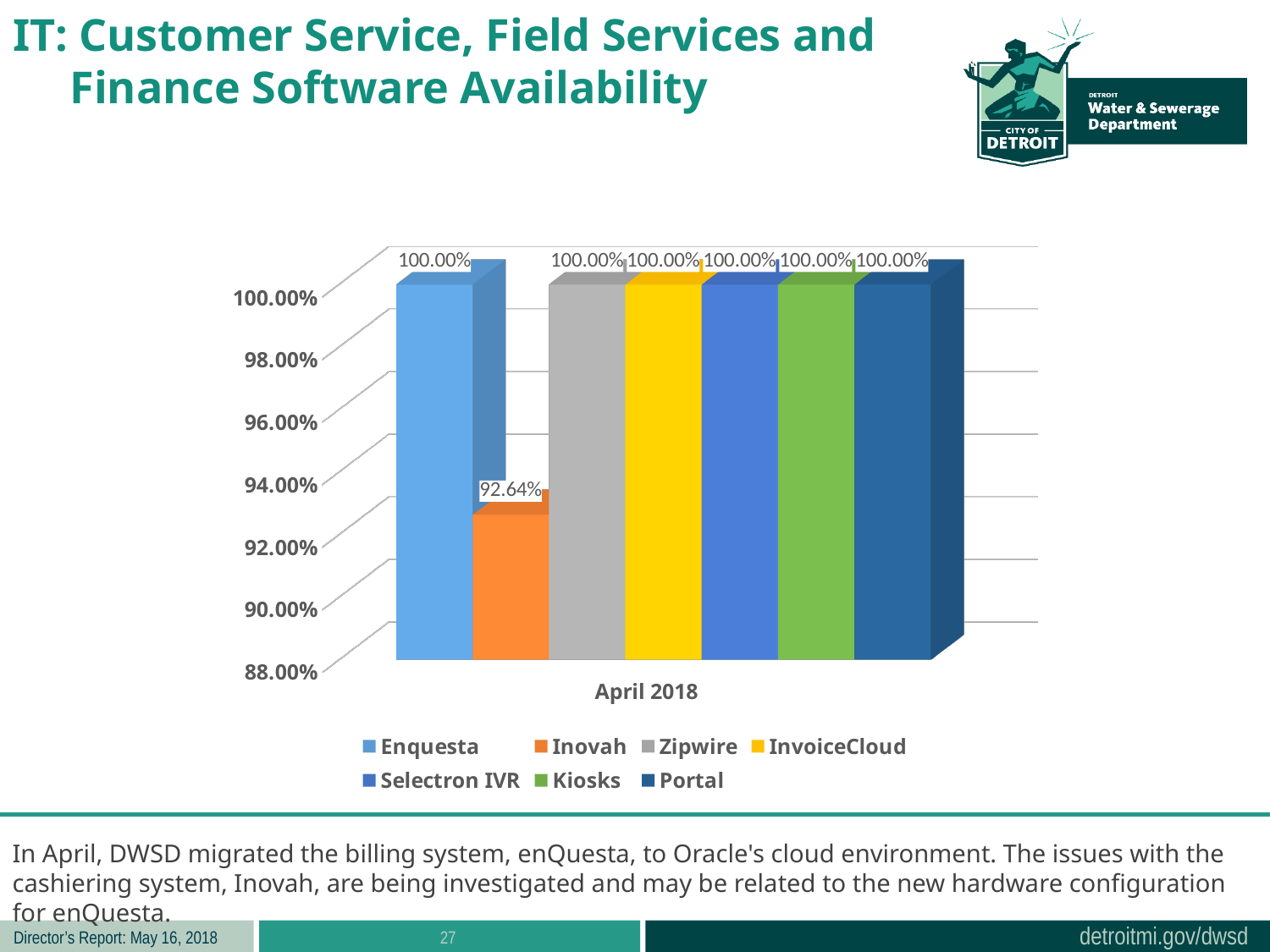
What kind of chart is shown on the slide? bar chart What is the availability value for Portal in April 2018? 100.00% Which software has the lowest availability in April 2018? Inovah What is the category label shown on the x axis? April 2018 What is the availability value for Inovah in April 2018? 92.64% What is the availability value for Enquesta in April 2018? 100.00% Is the value for Inovah greater or less than 94.00%? less How many series does the legend list? 7 What colour is the bar for Inovah? orange How many categories are shown on the x axis? 1 Which has higher availability, Inovah or Kiosks? Kiosks What is the difference between the availability of Zipwire and Inovah? 7.36%